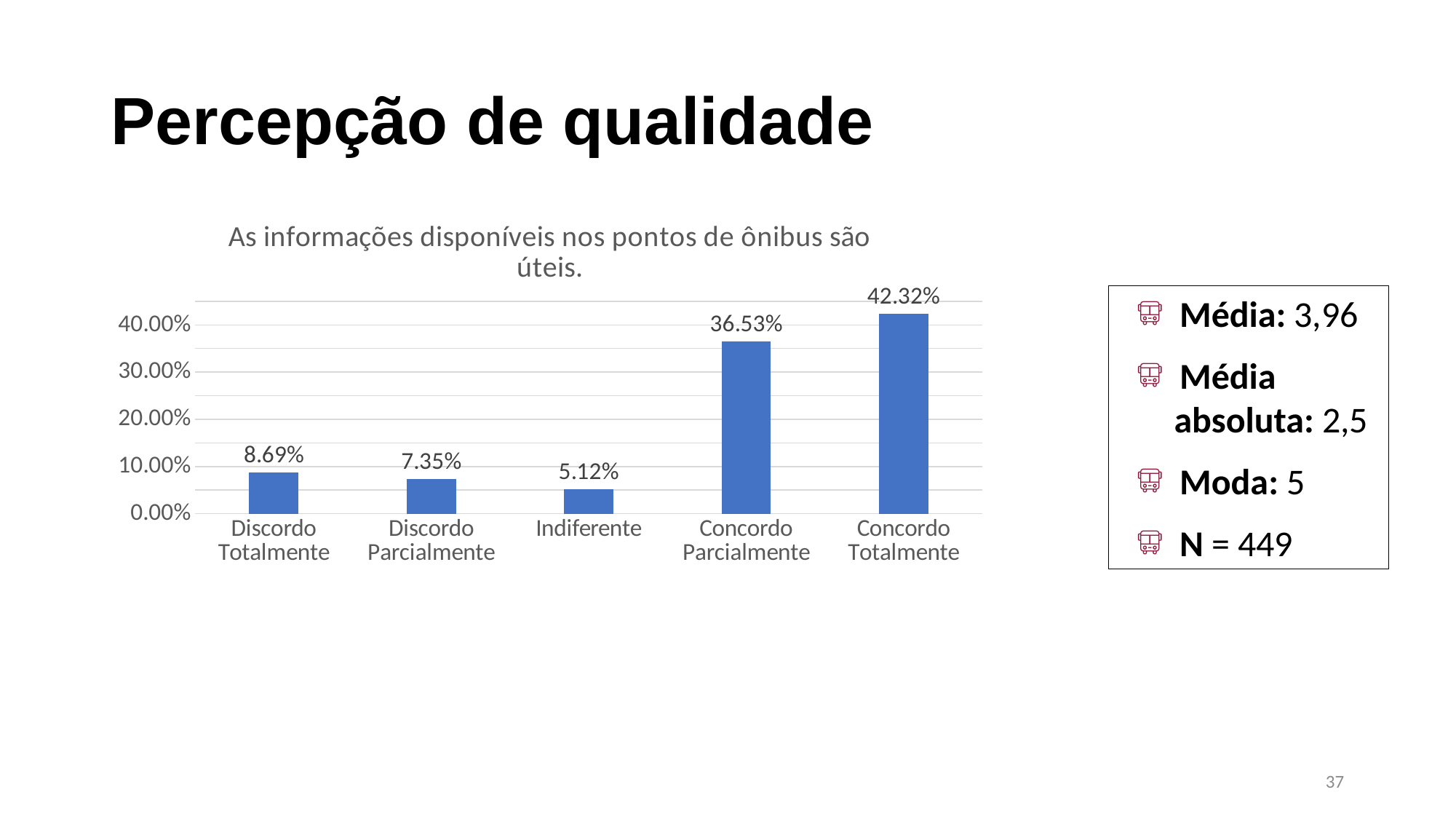
Is the value for Concordo Parcialmente greater or less than 30.00%? greater What is the value for Indiferente? 5.12% What is the title of the chart? As informações disponíveis nos pontos de ônibus são úteis. What is the difference between Discordo Totalmente and Discordo Parcialmente? 1.34% What kind of chart is shown? bar chart Which is larger, Discordo Totalmente or Indiferente? Discordo Totalmente How many categories are shown on the x axis? 5 What is the value for Concordo Totalmente? 42.32% Which category has the highest value? Concordo Totalmente What is the value for Discordo Parcialmente? 7.35% Which category has the lowest value? Indiferente What is the difference between Concordo Totalmente and Concordo Parcialmente? 5.79%